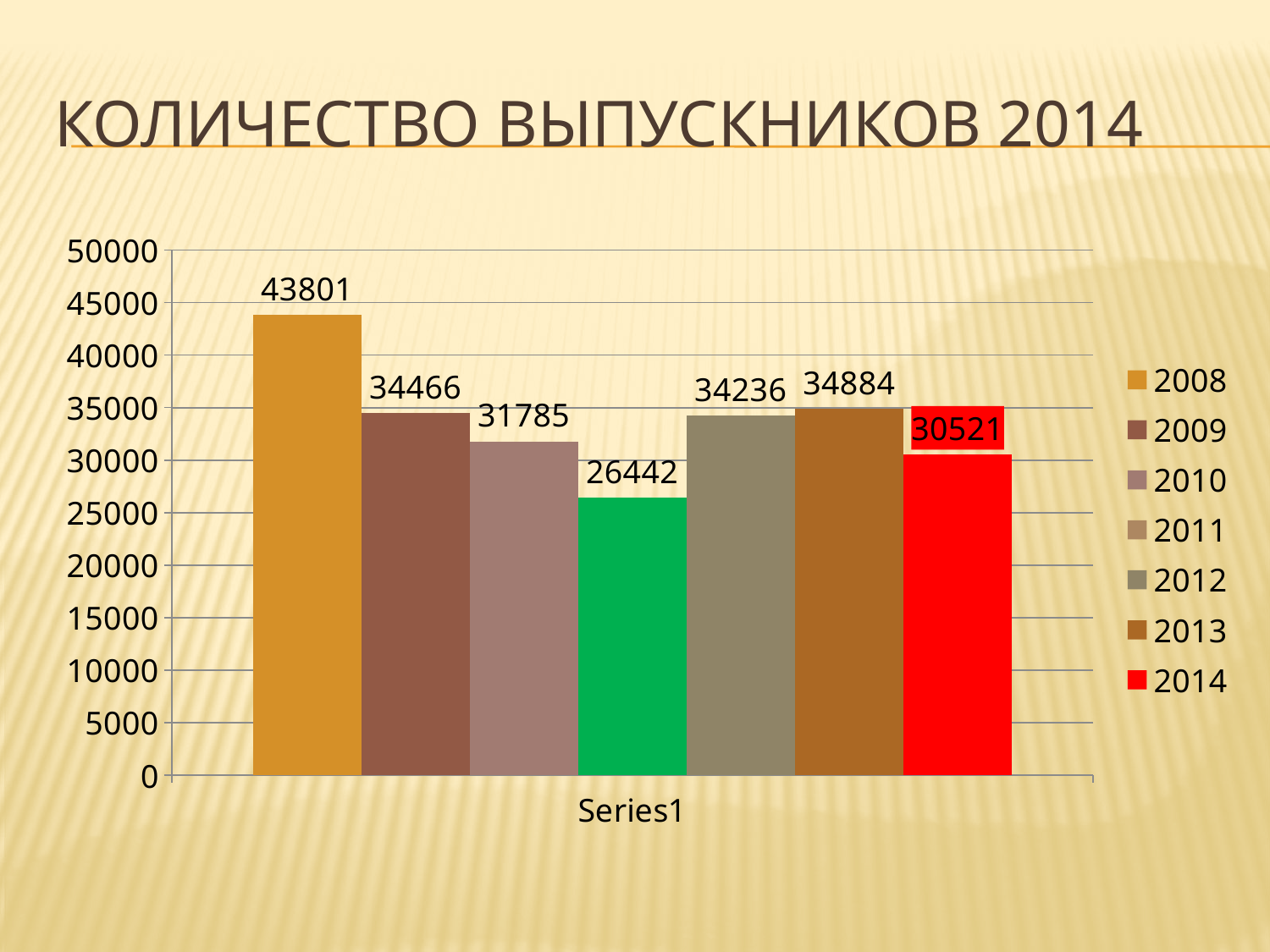
Is the value for 2012 greater or less than 30000? greater How many entries does the legend list? 7 What is the value for 2013? 34884 Which year has the highest value? 2008 What is the value for 2014? 30521 How many bars are shown in the chart? 7 What is the value for 2008? 43801 What kind of chart is shown on the slide? bar chart What is the difference between the values for 2008 and 2014? 13280 Which year has the lowest value? 2011 Which is larger, the value for 2009 or the value for 2010? 2009 What is the value for 2011? 26442